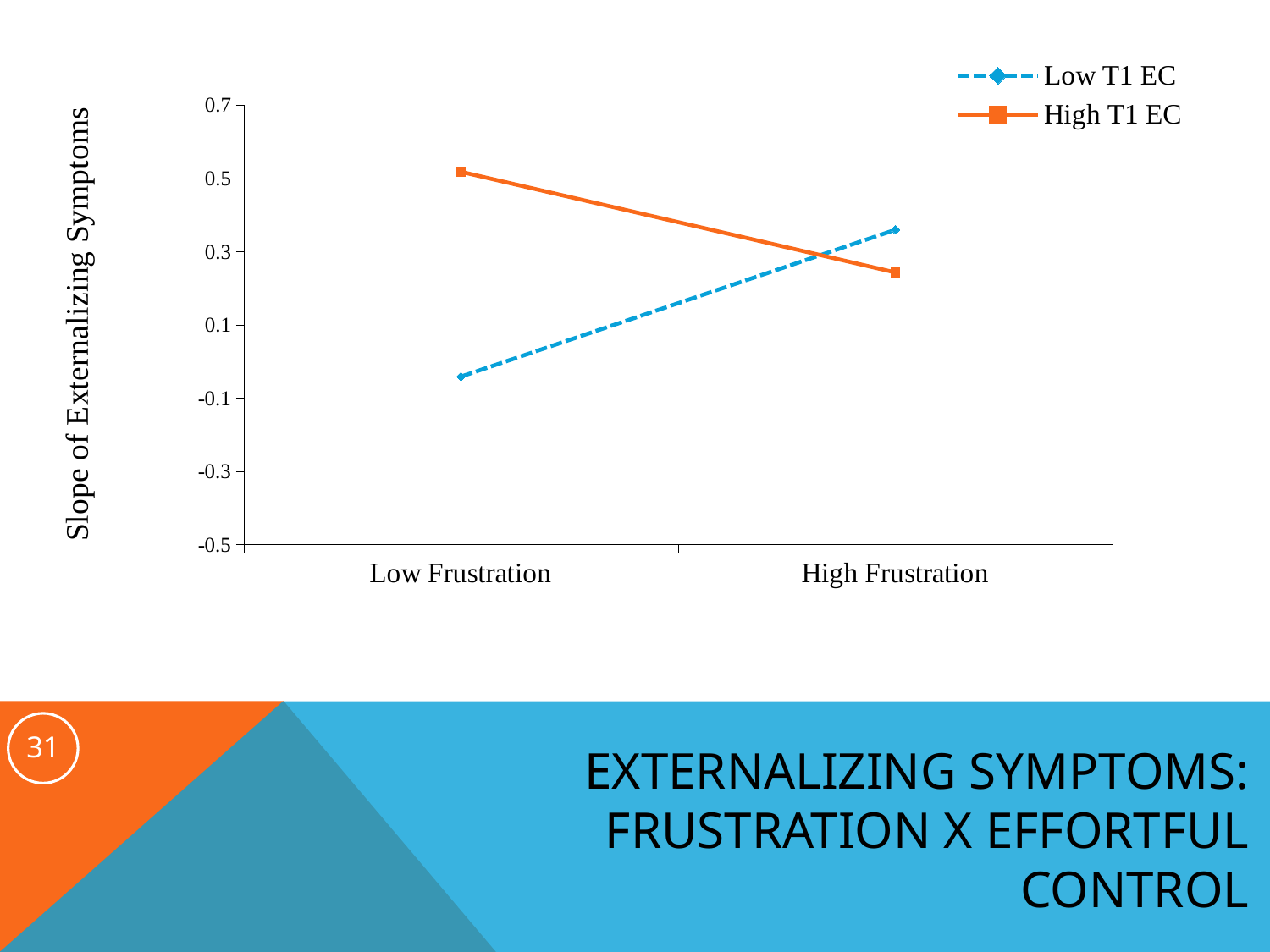
At Low Frustration, which series has the higher value, Low T1 EC or High T1 EC? High T1 EC Which series is drawn with a dashed line? Low T1 EC Does the Low T1 EC line rise or fall from Low Frustration to High Frustration? rise How many categories are shown on the x axis? 2 Is the value for Low T1 EC at High Frustration greater or less than 0.1? greater Is the value for High T1 EC at Low Frustration greater or less than 0.3? greater At High Frustration, which series has the higher value, Low T1 EC or High T1 EC? Low T1 EC How many series does the legend list? 2 Does the High T1 EC line rise or fall from Low Frustration to High Frustration? fall What kind of chart is shown on the slide? line chart What is the title of the y axis? Slope of Externalizing Symptoms Is the value for Low T1 EC at Low Frustration greater or less than 0.1? less